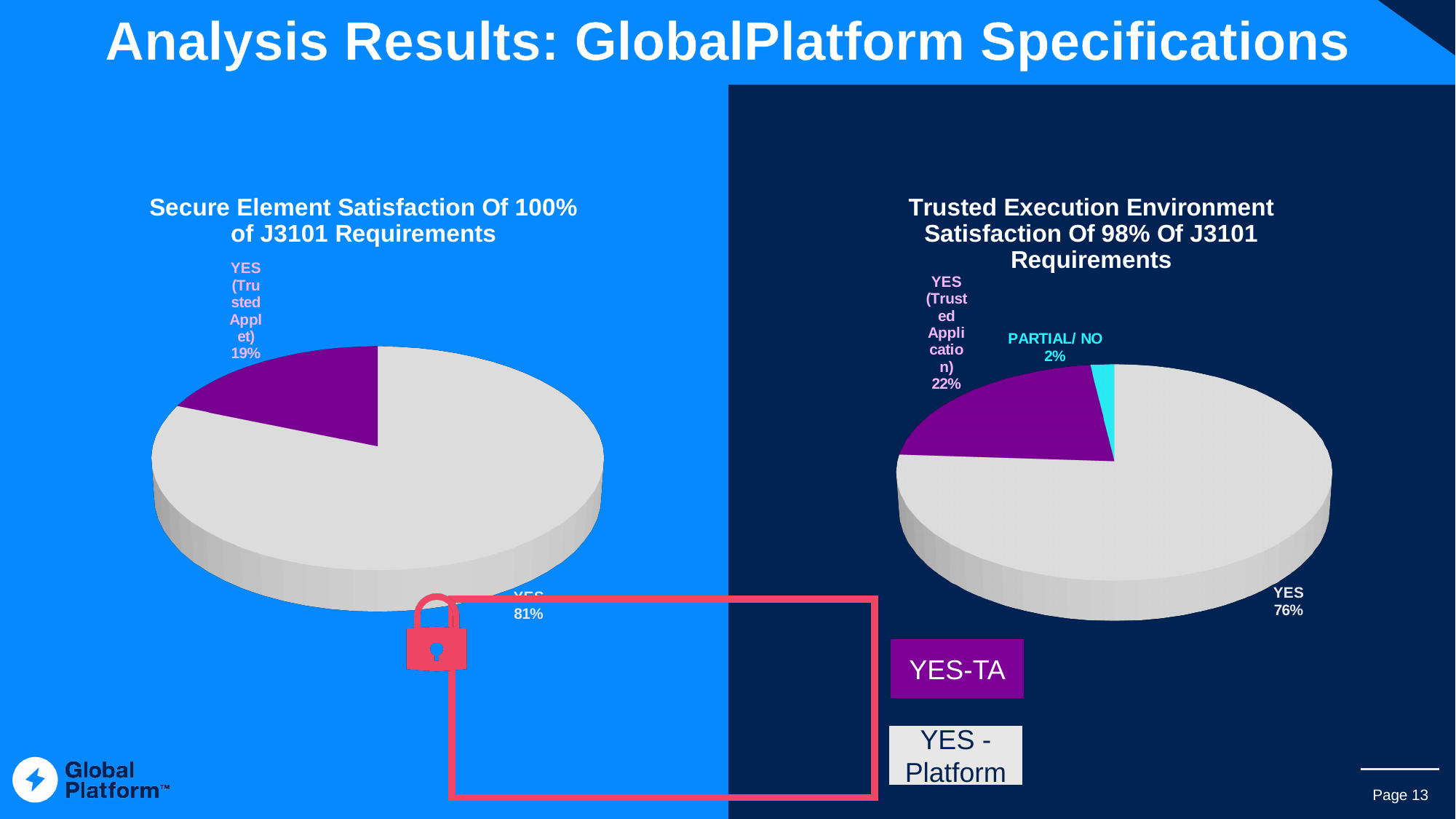
In the Secure Element Satisfaction chart, what share of the pie is labelled YES (Trusted Applet)? 19% In the Trusted Execution Environment Satisfaction chart, what is the difference in percentage points between the YES slice and the YES (Trusted Application) slice? 54 What type of chart is used for the Secure Element Satisfaction data? Pie chart In the Trusted Execution Environment Satisfaction chart, which slice is the smallest? PARTIAL/ NO How many slices does the Secure Element Satisfaction chart have? 2 In the Secure Element Satisfaction chart, what is the difference in percentage points between the YES slice and the YES (Trusted Applet) slice? 62 How many slices does the Trusted Execution Environment Satisfaction chart have? 3 In the Trusted Execution Environment Satisfaction chart, what share is labelled PARTIAL/ NO? 2% In the Trusted Execution Environment Satisfaction chart, what share is labelled YES (Trusted Application)? 22% In the Trusted Execution Environment Satisfaction chart, what share is labelled YES? 76% In the Secure Element Satisfaction chart, which slice is the largest? YES In the Secure Element Satisfaction chart, what share of the pie is labelled YES? 81%